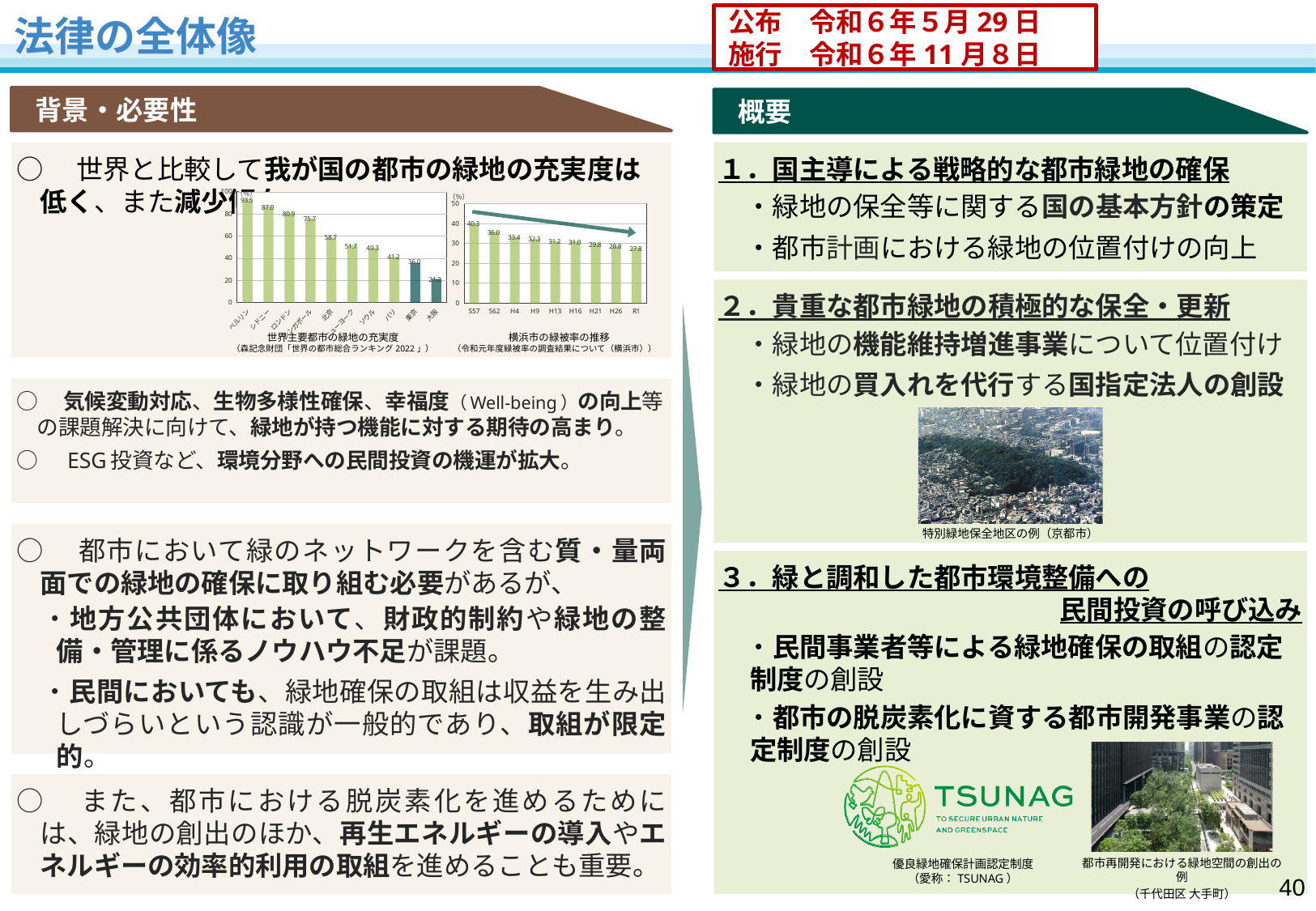
In the chart titled 横浜市の緑被率の推移, how many time points are plotted? 9 In the chart titled 世界主要都市の緑地の充実度, which is larger, the value for ソウル or the value for パリ? ソウル In the chart titled 横浜市の緑被率の推移, which year has the highest value? S57 What kind of chart is the chart titled 横浜市の緑被率の推移? bar chart In the chart titled 世界主要都市の緑地の充実度, which city has the lowest value? 大阪 In the chart titled 横浜市の緑被率の推移, what is the difference between the S57 value and the R1 value? 12.5 In the chart titled 世界主要都市の緑地の充実度, how many cities are plotted? 10 In the chart titled 横浜市の緑被率の推移, what is the value for R1? 27.8 In the chart titled 世界主要都市の緑地の充実度, what is the value for 東京? 36.0 In the chart titled 横浜市の緑被率の推移, do the values rise or fall from S57 to R1? fall In the chart titled 横浜市の緑被率の推移, what is the value for S57? 40.3 In the chart titled 世界主要都市の緑地の充実度, what is the value for 大阪? 21.2